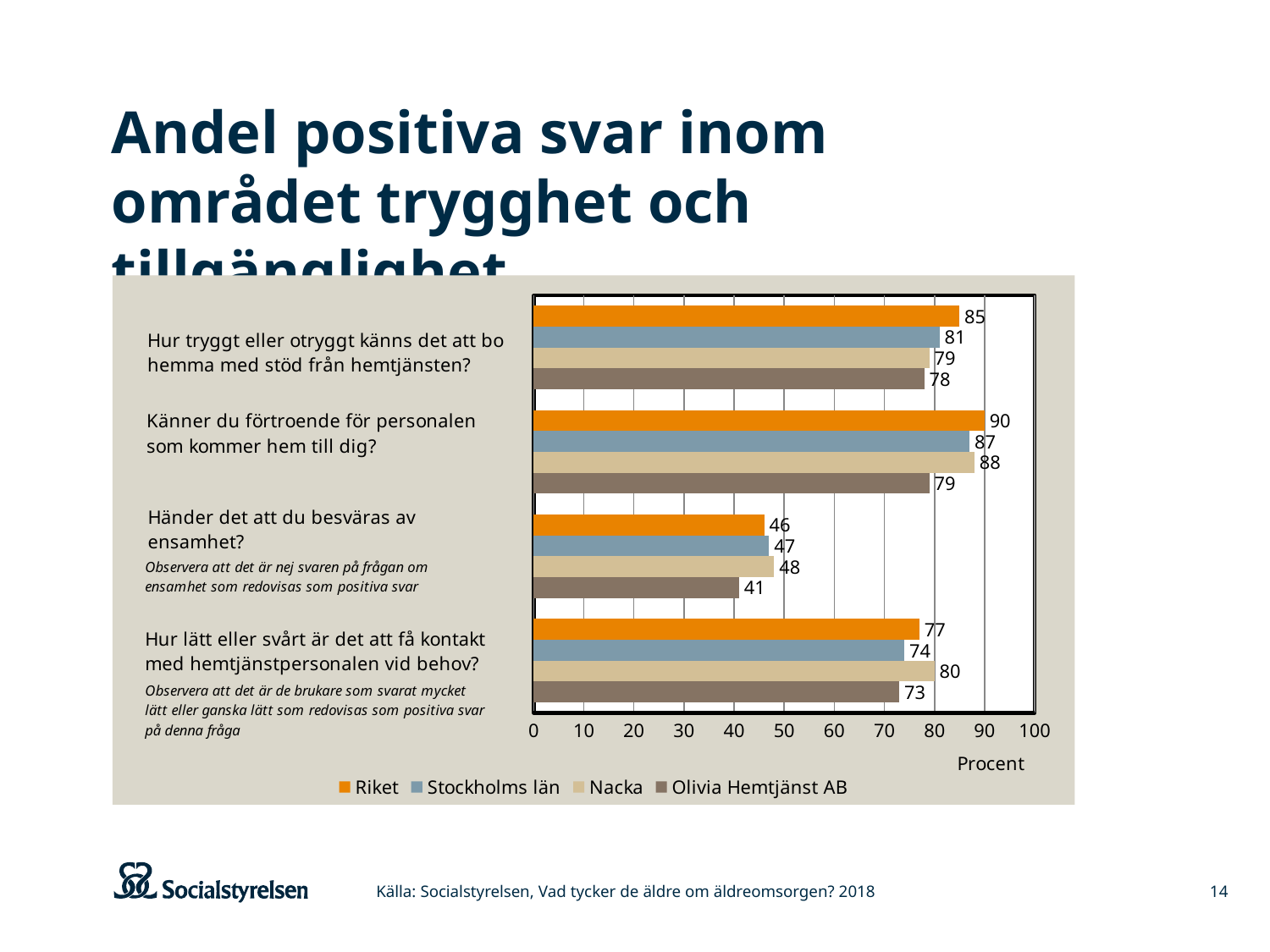
What is the value for Nacka on the question "Hur lätt eller svårt är det att få kontakt med hemtjänstpersonalen vid behov?"? 80 How many question categories are shown in the chart? 4 What is the value for Olivia Hemtjänst AB on the question "Händer det att du besväras av ensamhet?"? 41 What is the value for Riket on the question "Känner du förtroende för personalen som kommer hem till dig?"? 90 What is the difference between Riket and Olivia Hemtjänst AB on the question "Känner du förtroende för personalen som kommer hem till dig?"? 11 How many series does the legend list? 4 What kind of chart is shown on the slide? Bar chart Which series has the lowest value on the question "Hur lätt eller svårt är det att få kontakt med hemtjänstpersonalen vid behov?"? Olivia Hemtjänst AB Which is larger on the question "Hur tryggt eller otryggt känns det att bo hemma med stöd från hemtjänsten?": Riket or Nacka? Riket What is the value for Stockholms län on the question "Hur tryggt eller otryggt känns det att bo hemma med stöd från hemtjänsten?"? 81 Is the value for Nacka on the question "Händer det att du besväras av ensamhet?" greater or less than 50? less Which series has the highest value on the question "Känner du förtroende för personalen som kommer hem till dig?"? Riket